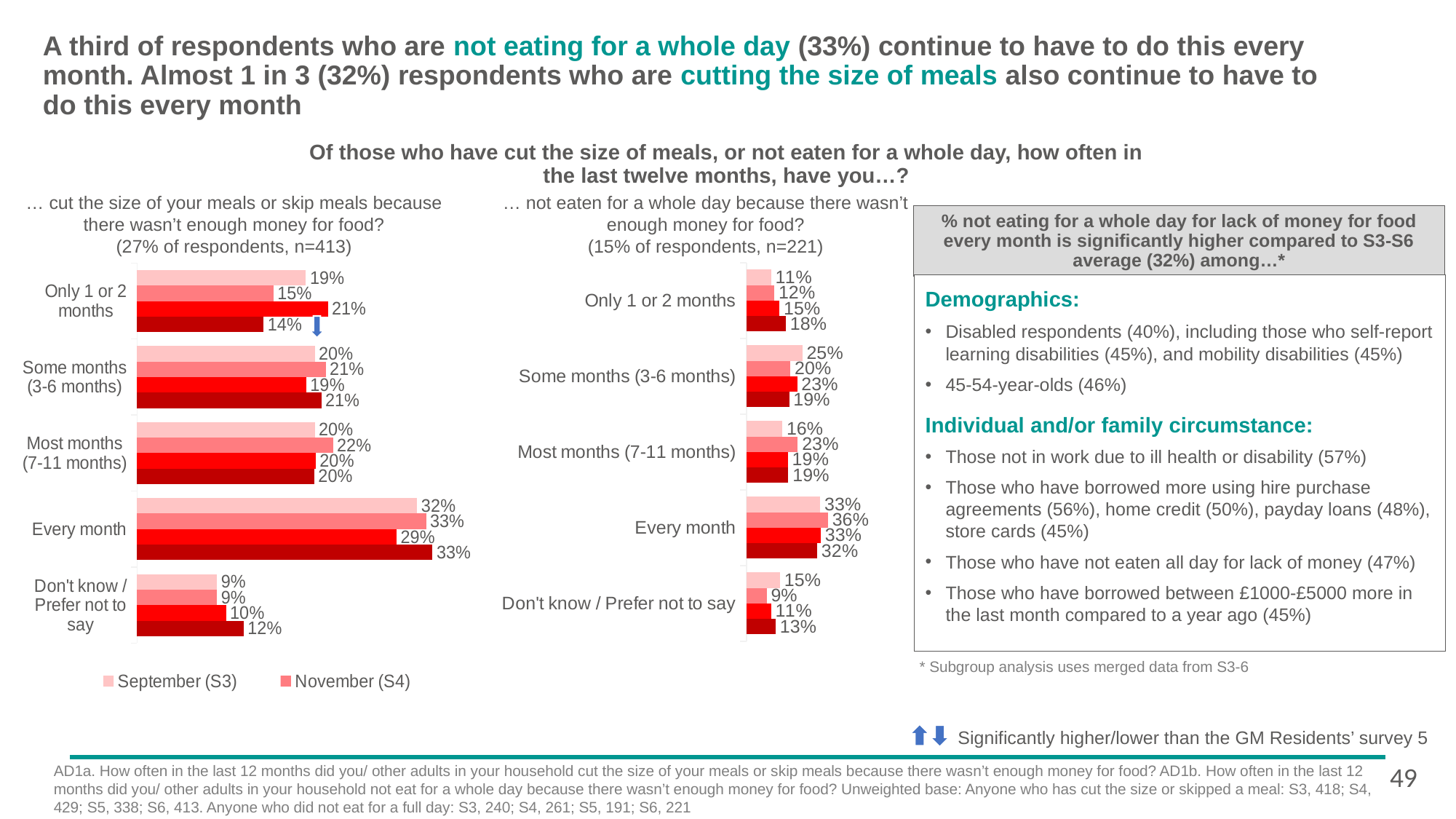
In the right chart (not eaten for a whole day), which is larger for 'Most months (7-11 months)': the September (S3) value or the November (S4) value? November (S4) How many categories are shown on the left chart (cut the size of your meals or skip meals)? 5 What percentage of respondents and sample size are given in the subtitle of the right chart (not eaten for a whole day)? 15% of respondents, n=221 In the left chart (cut the size of your meals or skip meals), which category has the highest September (S3) value? Every month In the right chart (not eaten for a whole day), what is the November (S4) value for 'Every month'? 36% What type of chart is used for the 'not eaten for a whole day' data? Bar chart In the left chart (cut the size of your meals or skip meals), what is the November (S4) value for 'Only 1 or 2 months'? 15% In the right chart (not eaten for a whole day), which category has the lowest November (S4) value? Don't know / Prefer not to say In the left chart (cut the size of your meals or skip meals), what is the September (S3) value for 'Every month'? 32% In the right chart (not eaten for a whole day), what is the value of the darkest (bottom) bar for 'Only 1 or 2 months'? 18% In the right chart (not eaten for a whole day), what is the September (S3) value for 'Some months (3-6 months)'? 25% In the left chart (cut the size of your meals or skip meals), what is the difference between the September (S3) values for 'Every month' and 'Don't know / Prefer not to say'? 23 percentage points